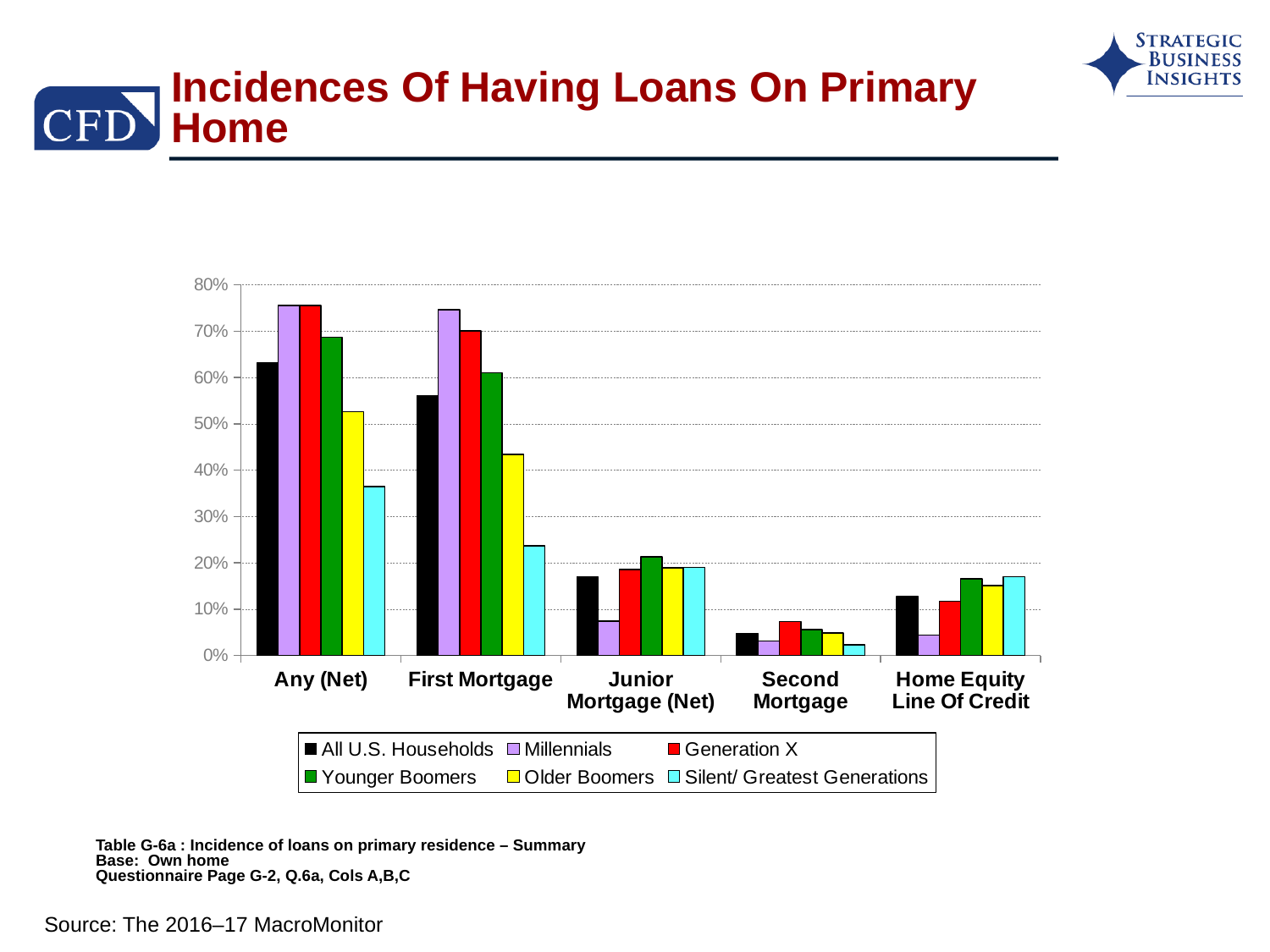
Which series has the lowest value in the Any (Net) category? Silent/ Greatest Generations Is the value for Younger Boomers in the Any (Net) category greater or less than 60%? greater Is the value for Silent/ Greatest Generations in the Any (Net) category greater or less than 40%? less How many loan categories are shown along the x axis? 5 What colour represents Generation X in the legend? Red In the Junior Mortgage (Net) category, which is larger: Millennials or Younger Boomers? Younger Boomers What kind of chart is shown on the slide? Bar chart In the Any (Net) category, which is larger: Millennials or Older Boomers? Millennials Is the value for Older Boomers in the First Mortgage category greater or less than 50%? less Which series has the lowest value in the Home Equity Line Of Credit category? Millennials How many series does the legend list? 6